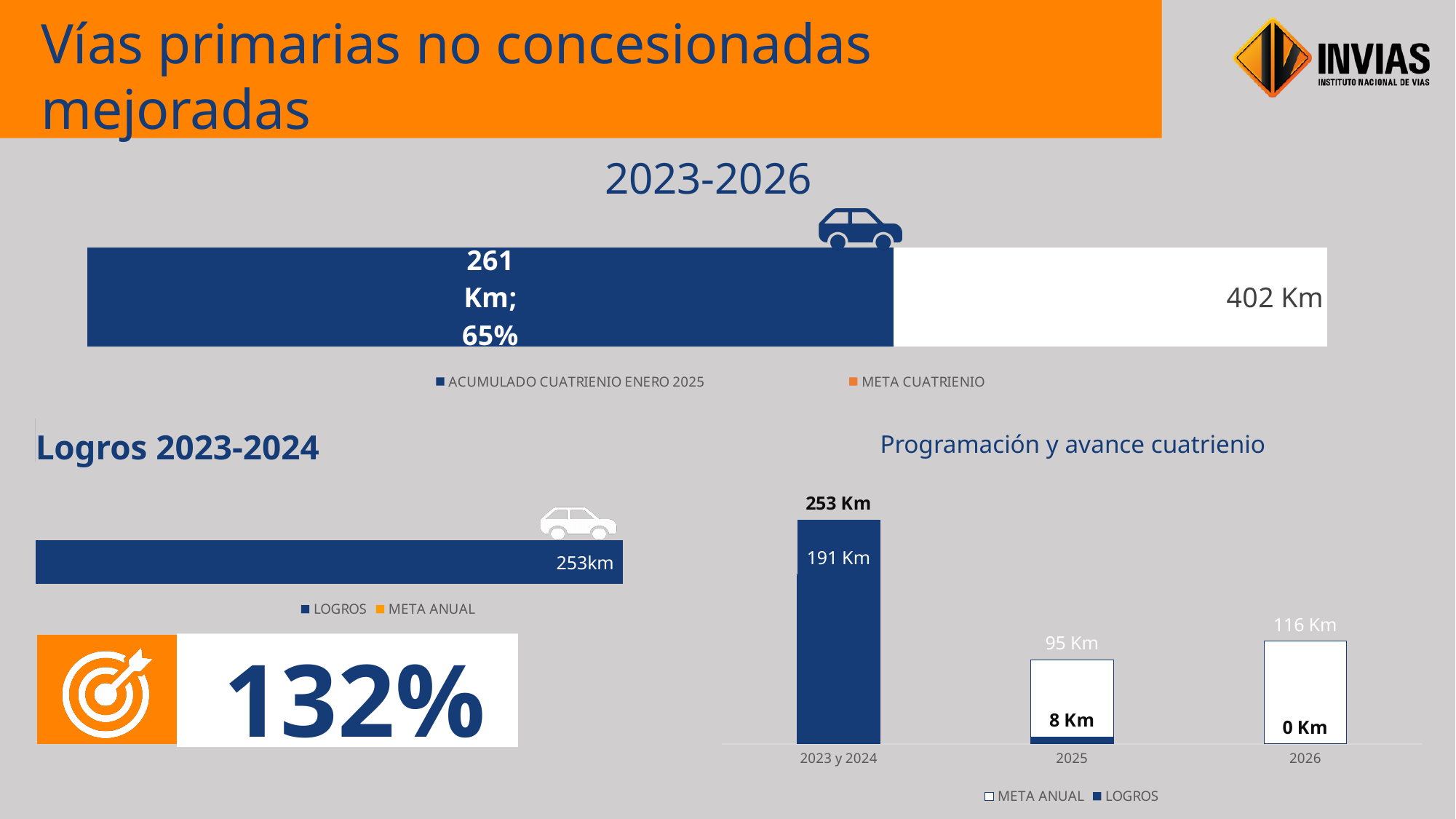
In the 'Programación y avance cuatrienio' chart, what is the LOGROS value for 2023 y 2024? 253 Km In the '2023-2026' chart, what percentage is shown on the ACUMULADO CUATRIENIO ENERO 2025 bar? 65% In the 'Programación y avance cuatrienio' chart, what is the difference between LOGROS and META ANUAL for 2023 y 2024? 62 Km In the 'Logros 2023-2024' chart, how many series does the legend list? 2 In the '2023-2026' chart, what is the value for ACUMULADO CUATRIENIO ENERO 2025? 261 Km In the '2023-2026' chart, what is the difference between META CUATRIENIO and ACUMULADO CUATRIENIO ENERO 2025? 141 Km In the 'Programación y avance cuatrienio' chart, what is the META ANUAL value for 2025? 95 Km In the '2023-2026' chart, what is the value for META CUATRIENIO? 402 Km In the 'Programación y avance cuatrienio' chart, which category has the highest META ANUAL value? 2023 y 2024 In the 'Logros 2023-2024' chart, what is the value for LOGROS? 253km In the 'Programación y avance cuatrienio' chart, how many categories are shown on the x axis? 3 In the 'Programación y avance cuatrienio' chart, what is the LOGROS value for 2026? 0 Km